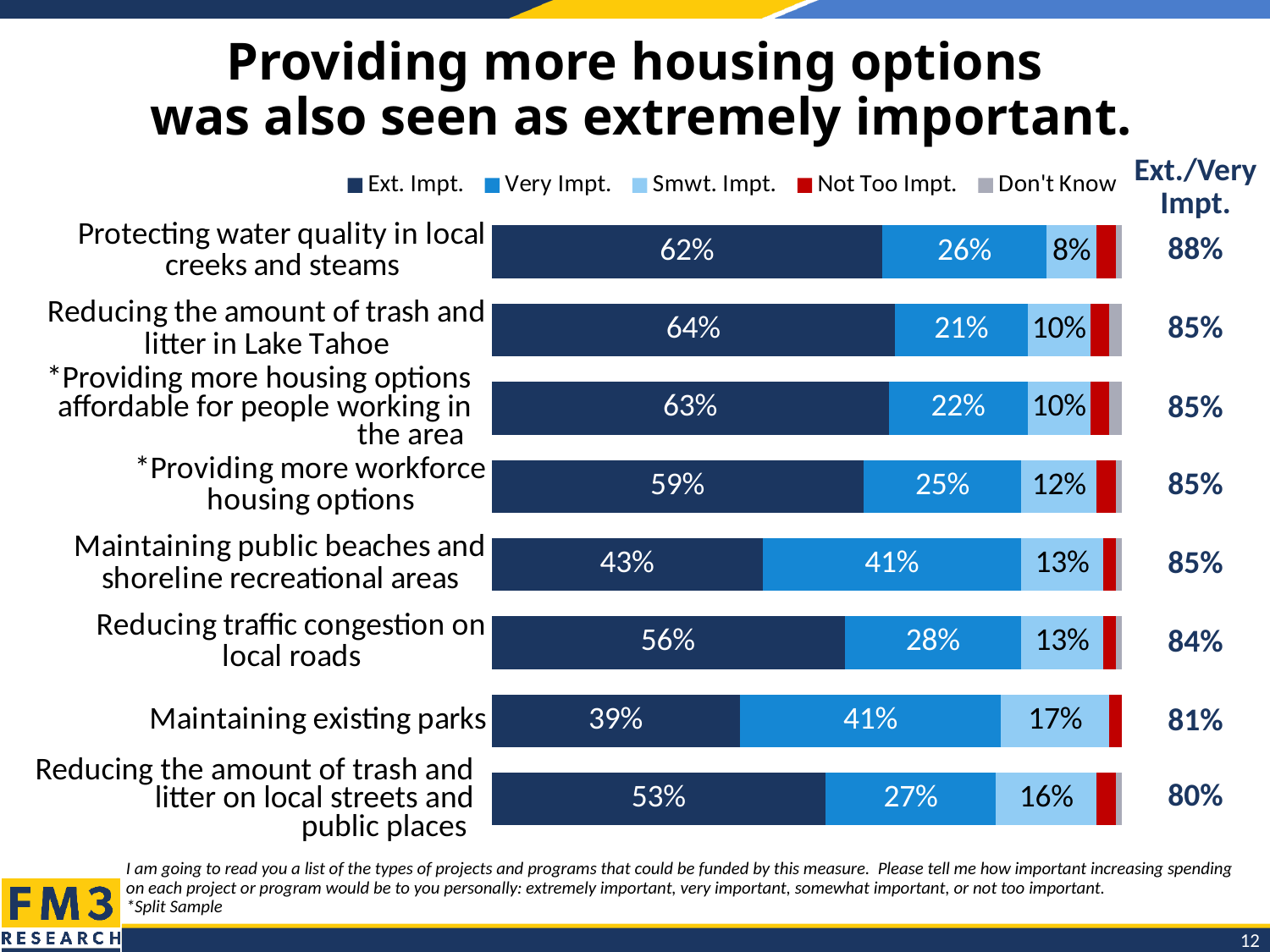
What is the Very Impt. value for 'Maintaining existing parks'? 41% Which has a larger Ext. Impt. value: 'Reducing traffic congestion on local roads' or 'Maintaining public beaches and shoreline recreational areas'? Reducing traffic congestion on local roads Which item has the highest Ext. Impt. percentage? Reducing the amount of trash and litter in Lake Tahoe What kind of chart is shown on the slide? Stacked bar chart What is the Smwt. Impt. value for 'Providing more workforce housing options'? 12% What is the Ext./Very Impt. combined value for 'Reducing traffic congestion on local roads'? 84% How many series does the legend list? 5 How many items (categories) are shown in the chart? 8 Which legend entry is shown in red? Not Too Impt. What is the difference in Ext. Impt. percentage between 'Reducing the amount of trash and litter in Lake Tahoe' and 'Reducing the amount of trash and litter on local streets and public places'? 11 percentage points Which item has the lowest Ext. Impt. percentage? Maintaining existing parks What percentage of respondents rated 'Protecting water quality in local creeks and steams' as Ext. Impt.? 62%